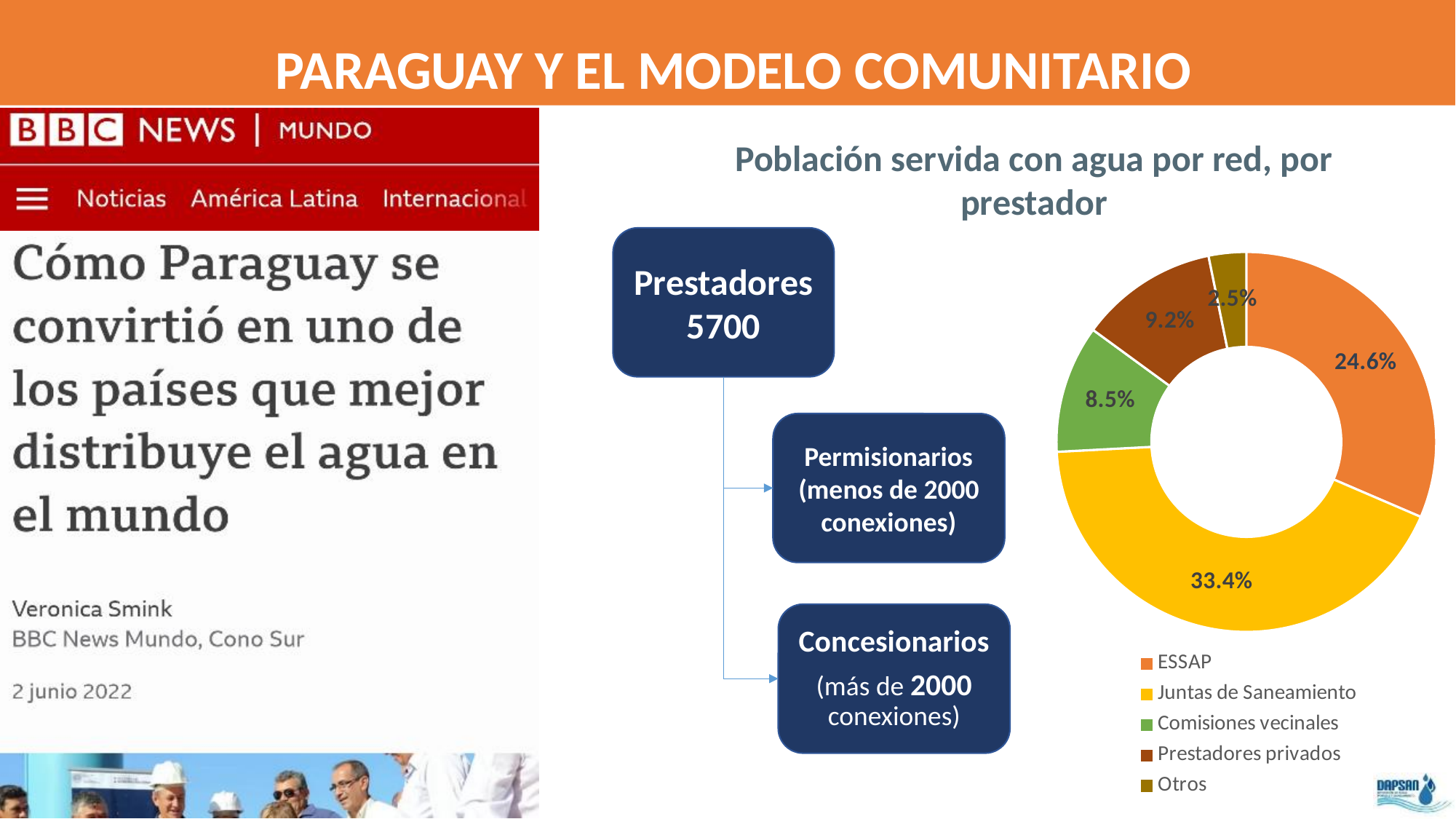
What is the value shown for Prestadores privados in the chart? 9.2% What is the value shown for ESSAP in the chart? 24.6% Which is larger, the value for Prestadores privados or the value for Comisiones vecinales? Prestadores privados What kind of chart is shown on the slide? doughnut chart What is the difference between the values for Juntas de Saneamiento and ESSAP? 8.8% Which category has the largest value in the chart? Juntas de Saneamiento What is the title of the chart on the slide? Población servida con agua por red, por prestador Which category has the smallest value in the chart? Otros What is the value shown for Comisiones vecinales in the chart? 8.5% What is the value shown for Juntas de Saneamiento in the chart 'Población servida con agua por red, por prestador'? 33.4% How many categories does the chart's legend list? 5 What is the value shown for Otros in the chart? 2.5%